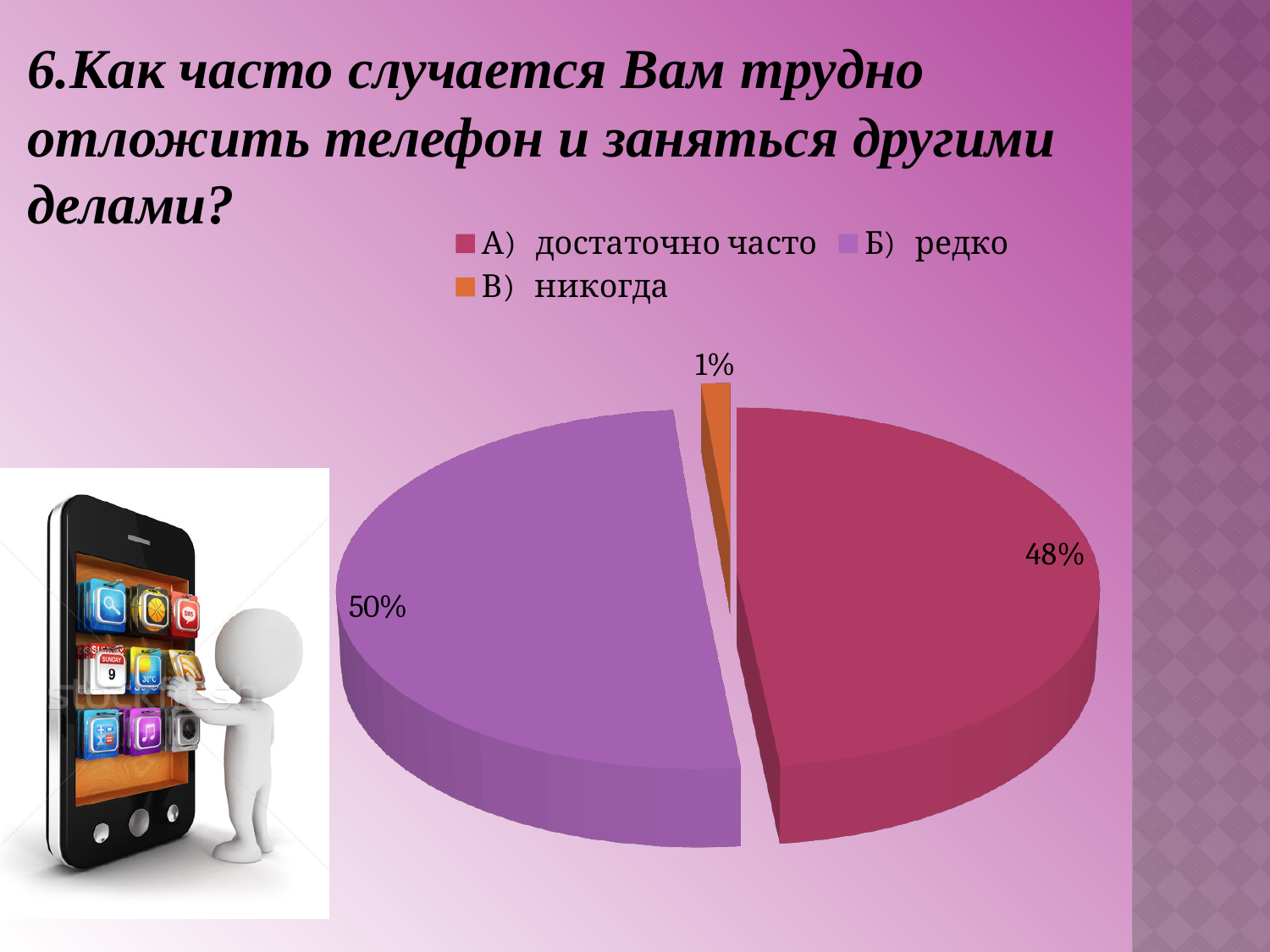
How many entries does the legend list? 3 What share of the pie does "А) достаточно часто" have? 48% What share of the pie does "В) никогда" have? 1% Which answer option has the smallest slice of the pie? В) никогда How many slices does the pie chart have? 3 Which is larger: the share for "А) достаточно часто" or the share for "В) никогда"? А) достаточно часто What is the difference between the shares for "Б) редко" and "А) достаточно часто"? 2% What kind of chart is shown on the slide? pie chart What colour is the slice for "В) никогда"? orange What share of the pie does "Б) редко" have? 50% Which answer option has the largest slice of the pie? Б) редко What is the difference between the shares for "А) достаточно часто" and "В) никогда"? 47%